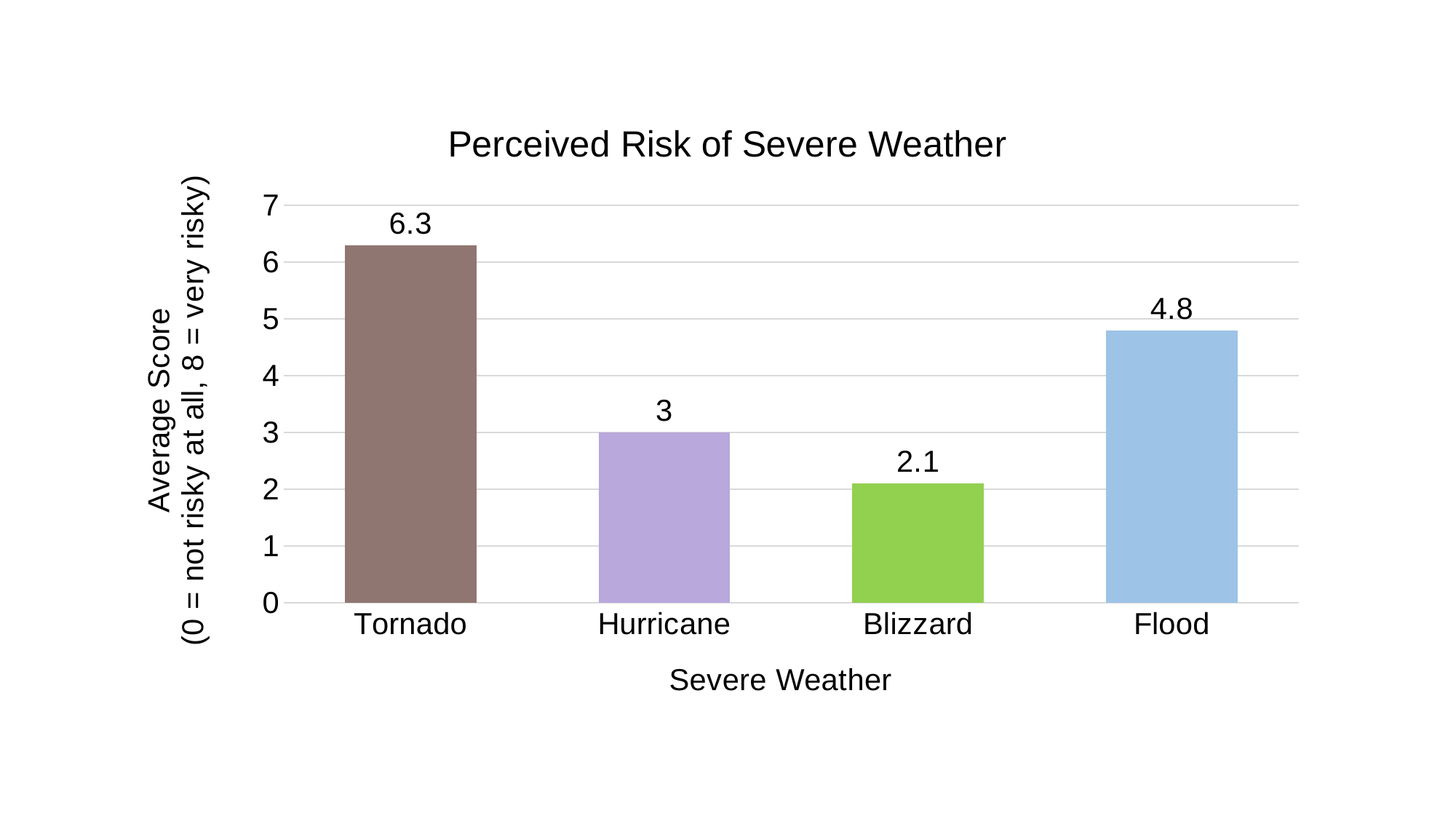
What is the average perceived risk score for Hurricane? 3 Which has a higher perceived risk score, Flood or Hurricane? Flood Which severe weather type has the highest perceived risk score? Tornado What is the difference between the perceived risk scores for Tornado and Flood? 1.5 What is the average perceived risk score for Tornado? 6.3 What is the average perceived risk score for Flood? 4.8 What is the title of the chart? Perceived Risk of Severe Weather What is the difference between the perceived risk scores for Hurricane and Blizzard? 0.9 How many severe weather types are shown in the chart? 4 What is the average perceived risk score for Blizzard? 2.1 Which severe weather type has the lowest perceived risk score? Blizzard What kind of chart is shown on the slide? Bar chart